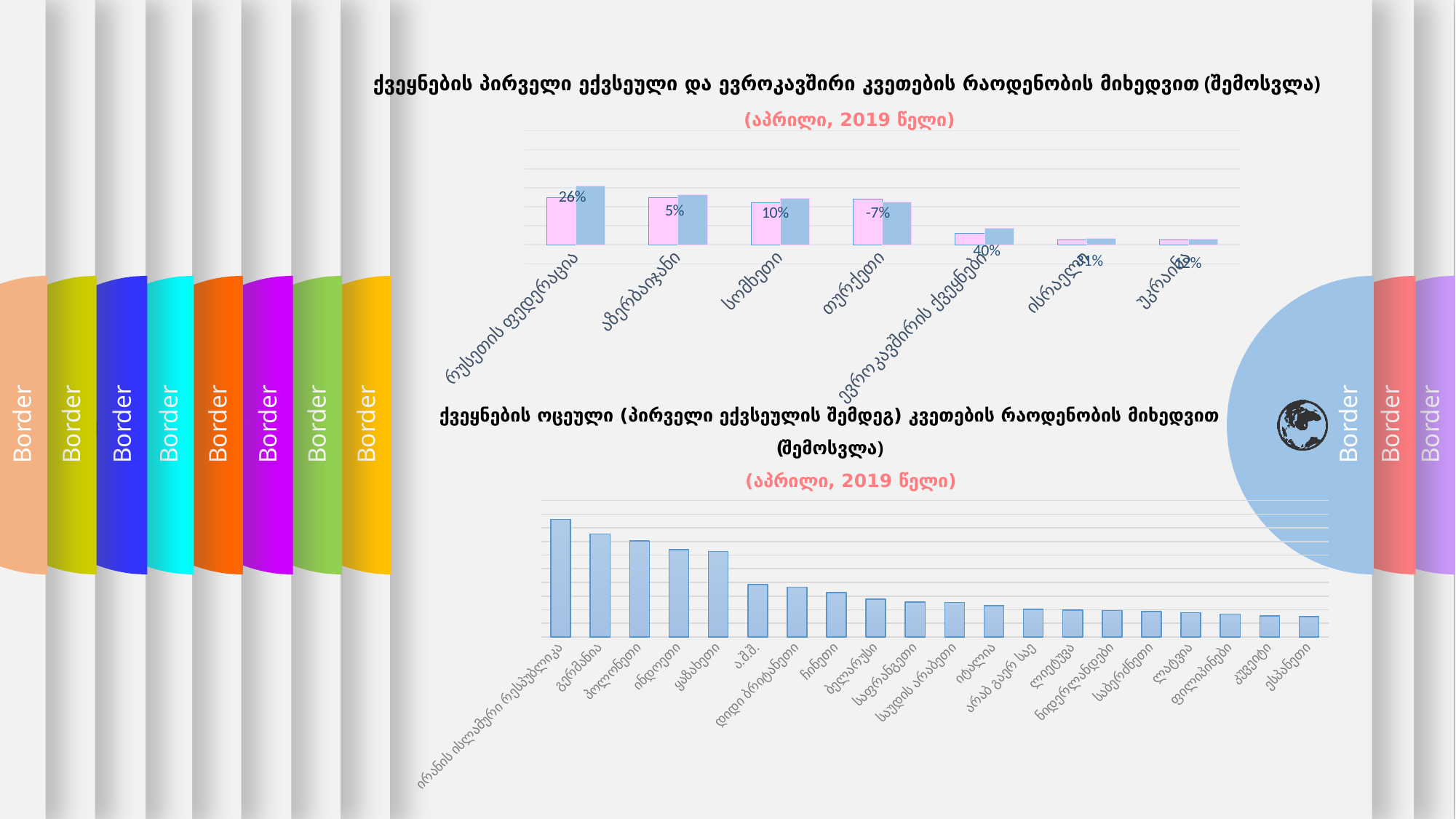
In the bottom chart, which category has the lowest bar? ესპანეთი In the bottom chart, which has the taller bar, გერმანია or ყაზახეთი? გერმანია In the top chart, do the bar heights generally rise or fall from left to right along the x axis? fall In the top chart, what is the data label shown for აზერბაიჯანი? 5% In the top chart, what is the data label shown for ევროკავშირის ქვეყნები? 40% In the bottom chart, which category has the highest bar? ირანის ისლამური რესპუბლიკა In the top chart, which category has the tallest bars? რუსეთის ფედერაცია What type of chart is the top chart on the slide? bar chart How many categories are shown on the x axis of the bottom chart? 20 In the top chart, what is the data label shown for რუსეთის ფედერაცია? 26% In the top chart, what is the data label shown for თურქეთი? -7% How many categories are shown on the x axis of the top chart? 7